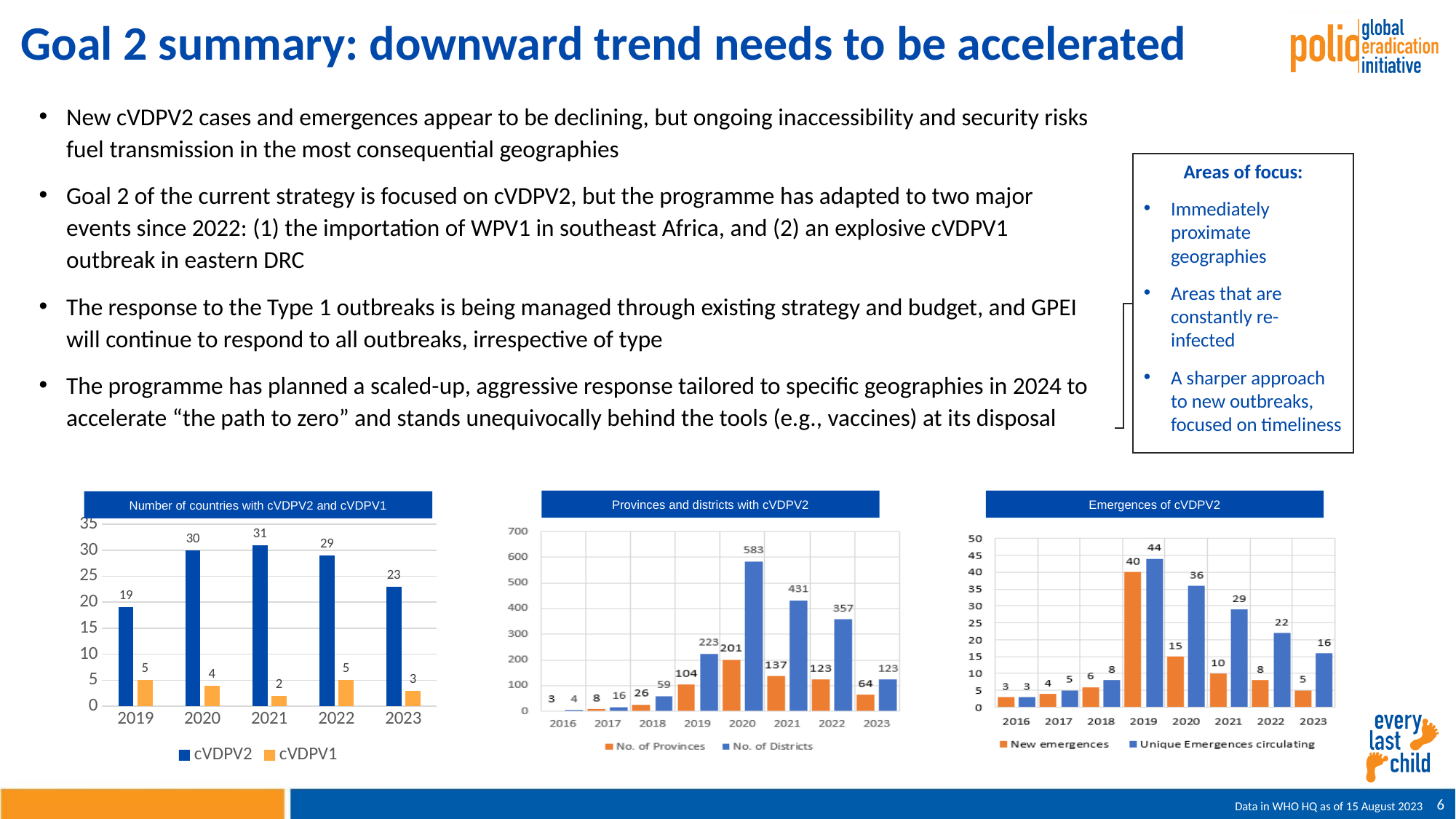
In the 'Number of countries with cVDPV2 and cVDPV1' chart, which year has the lowest cVDPV1 value? 2021 In the 'Provinces and districts with cVDPV2' chart, how many years are shown on the x axis? 8 In the 'Provinces and districts with cVDPV2' chart, what is the difference between the number of districts and the number of provinces in 2022? 234 In the 'Provinces and districts with cVDPV2' chart, which year has the highest number of provinces? 2020 In the 'Number of countries with cVDPV2 and cVDPV1' chart, what is the difference between the cVDPV2 values for 2020 and 2023? 7 In the 'Number of countries with cVDPV2 and cVDPV1' chart, how many countries had cVDPV2 in 2021? 31 In the 'Emergences of cVDPV2' chart, how many new emergences were there in 2019? 40 What kind of chart is the 'Emergences of cVDPV2' chart? Bar chart In the 'Emergences of cVDPV2' chart, which is larger in 2021: new emergences or unique emergences circulating? Unique emergences circulating In the 'Number of countries with cVDPV2 and cVDPV1' chart, how many series does the legend list? 2 In the 'Emergences of cVDPV2' chart, do the unique emergences circulating values rise or fall from 2019 to 2023? Fall In the 'Provinces and districts with cVDPV2' chart, what is the number of districts in 2020? 583